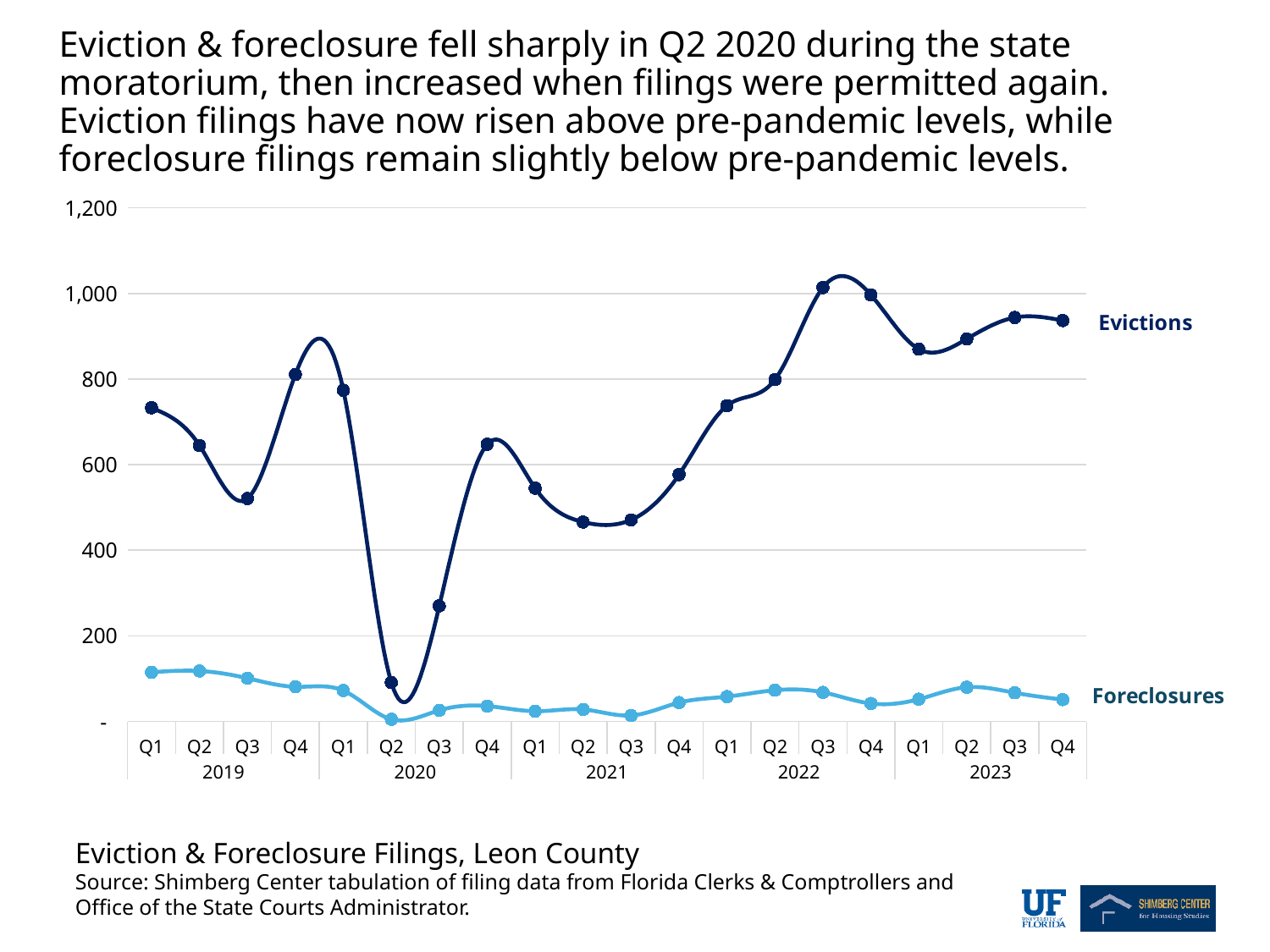
In which quarter is the Evictions value lowest? Q2 2020 Is the Foreclosures value for Q1 2019 greater or less than 200? less What is the title of the chart? Eviction & Foreclosure Filings, Leon County Is the Evictions value for Q2 2020 greater or less than 200? less How many series are plotted on the chart? 2 What kind of chart is shown on the slide? Line chart How many quarterly data points does each line have? 20 Do Evictions rise or fall from Q1 2021 to Q3 2022? rise Is the Evictions value for Q1 2019 greater or less than 800? less Which is larger, the Evictions value for Q1 2019 or for Q3 2019? Q1 2019